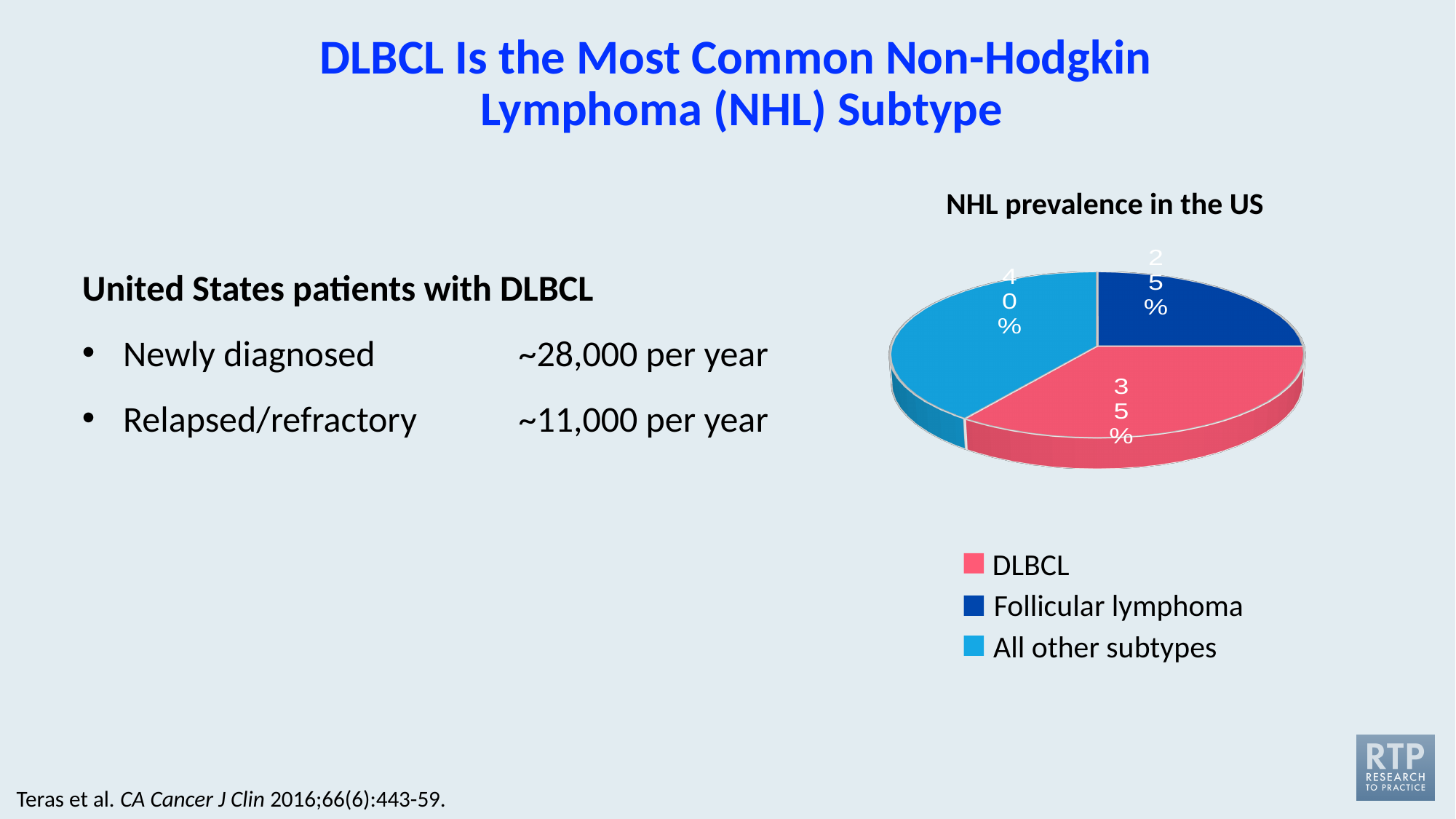
What is the title of the chart? NHL prevalence in the US What kind of chart is shown on the slide? Pie chart How many entries does the legend list? 3 How many slices does the pie chart have? 3 Which category has the largest slice of the pie? All other subtypes What share of the pie does Follicular lymphoma account for? 25% Which is larger, the DLBCL slice or the All other subtypes slice? All other subtypes Which category has the smallest slice of the pie? Follicular lymphoma What is the difference in percentage points between DLBCL and Follicular lymphoma? 10 What colour is the DLBCL slice in the pie chart? Pink/red What share of the pie does DLBCL account for? 35% What share of the pie does All other subtypes account for? 40%